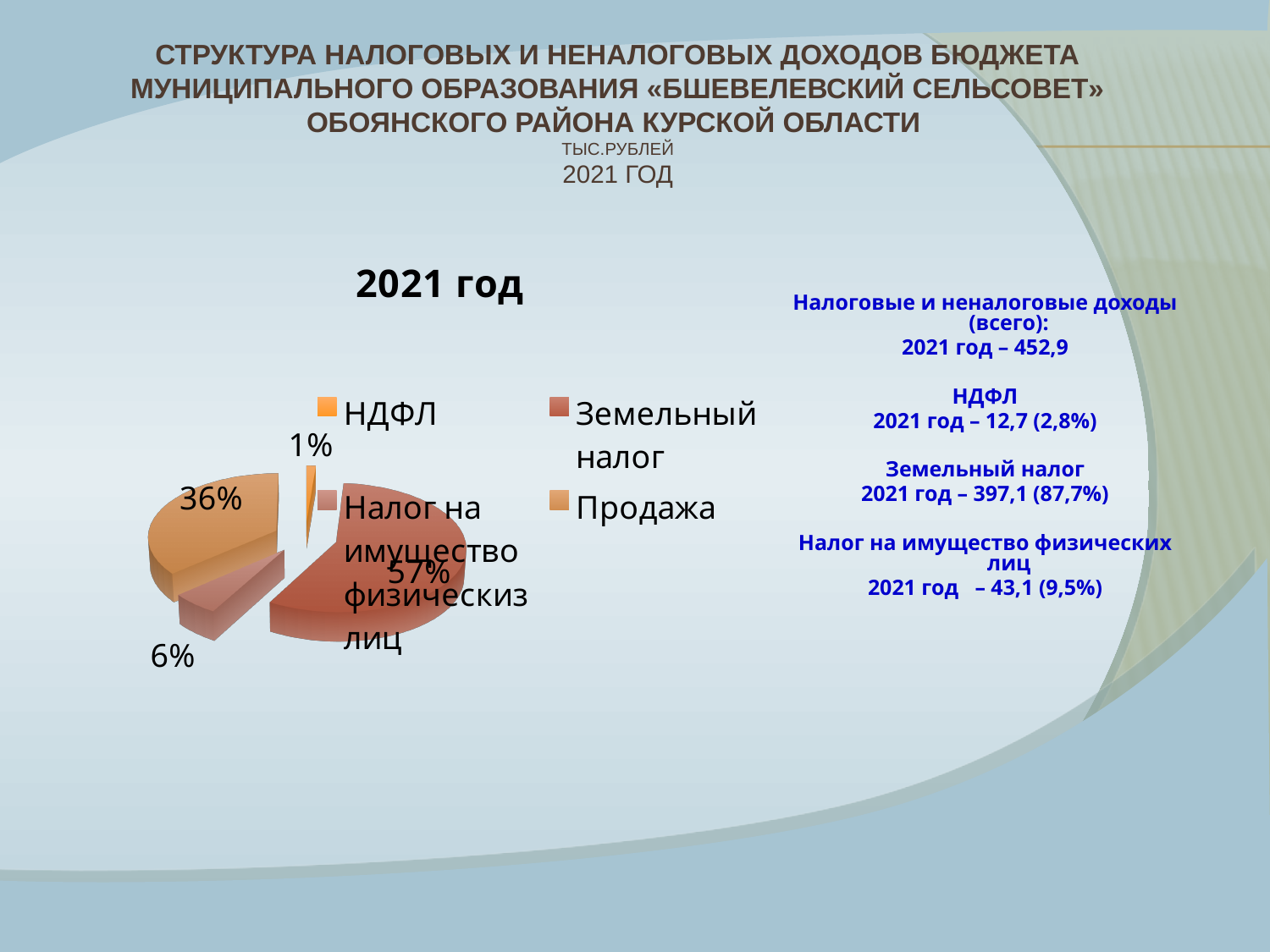
How many slices does the pie chart have? 4 What is the title of the pie chart? 2021 год What share of the pie does Земельный налог have? 57% By how many percentage points does the Земельный налог slice exceed the Продажа slice? 21 How many entries does the legend of the pie chart list? 4 Which category has the largest slice of the pie? Земельный налог What share of the pie does Продажа have? 36% What kind of chart is shown on the slide? pie chart Which category has the smallest slice of the pie? НДФЛ What share of the pie does Налог на имущество физическиз лиц have? 6% Which is larger in the pie chart: Продажа or Налог на имущество физическиз лиц? Продажа